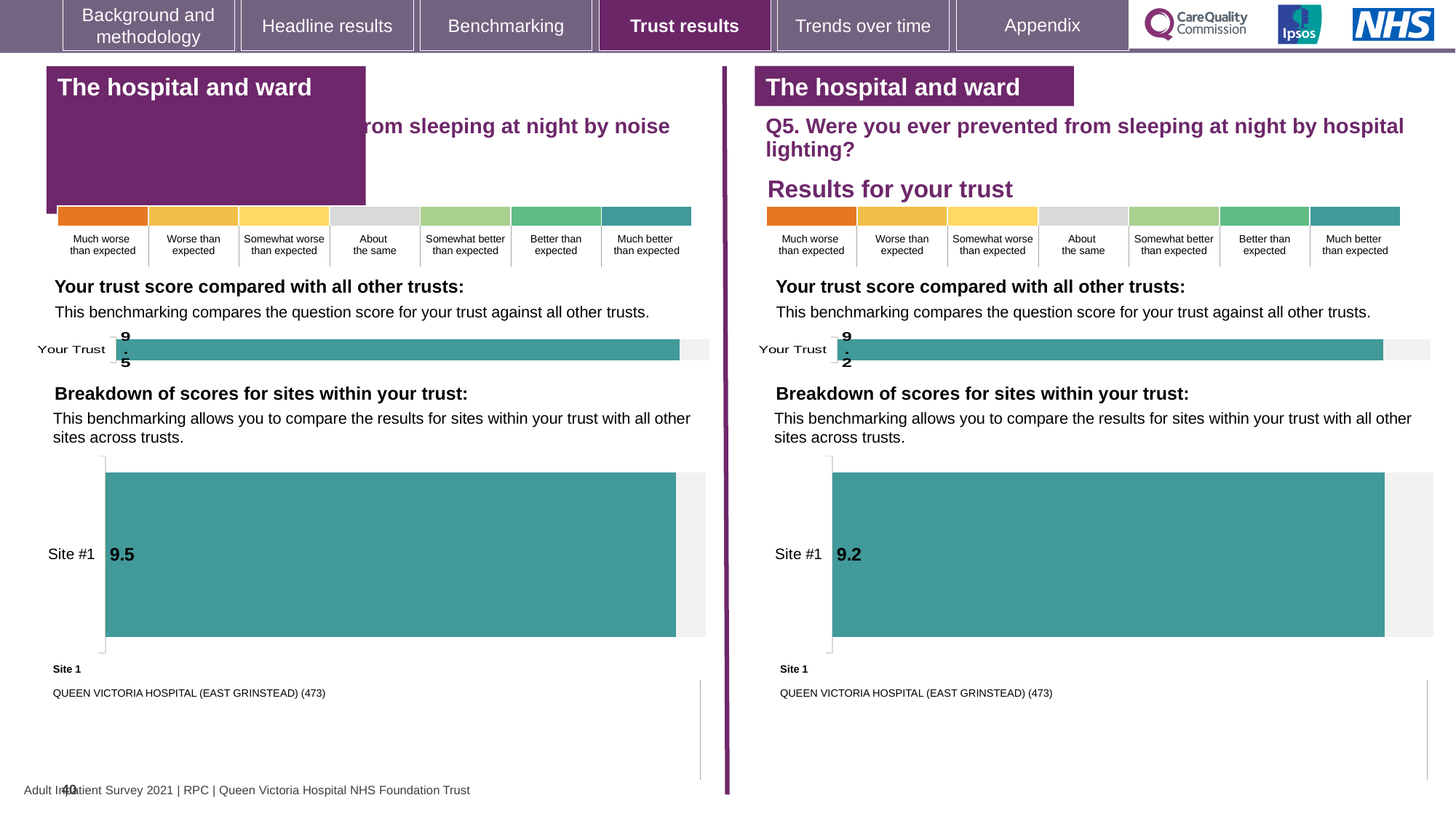
Which hospital is listed as Site 1 beneath the right-hand site breakdown chart? QUEEN VICTORIA HOSPITAL (EAST GRINSTEAD) (473) In the right-hand 'Breakdown of scores for sites within your trust' chart (Q5, hospital lighting), what is the score for Site #1? 9.2 What type of chart is used to show the Site #1 score in the right-hand 'Breakdown of scores for sites within your trust' section? Bar chart On the right-hand side of the slide (Q5, hospital lighting), what is the 'Your Trust' score shown in the trust score bar chart? 9.2 What is the difference between the 'Your Trust' score on the left-hand side and the 'Your Trust' score on the right-hand side of the slide? 0.3 What is the difference between the Site #1 score in the left-hand site breakdown chart and the Site #1 score in the right-hand site breakdown chart? 0.3 What colour are the bars in the 'Your Trust' and Site #1 charts on this slide? Teal Which is larger: the Site #1 score in the left-hand site breakdown chart or the Site #1 score in the right-hand site breakdown chart? The left-hand chart (9.5) How many sites are plotted in the right-hand 'Breakdown of scores for sites within your trust' chart? 1 On the left-hand side of the slide, what is the 'Your Trust' score shown in the trust score bar chart? 9.5 How many sites are plotted in the left-hand 'Breakdown of scores for sites within your trust' chart? 1 In the left-hand 'Breakdown of scores for sites within your trust' chart, what is the score for Site #1? 9.5